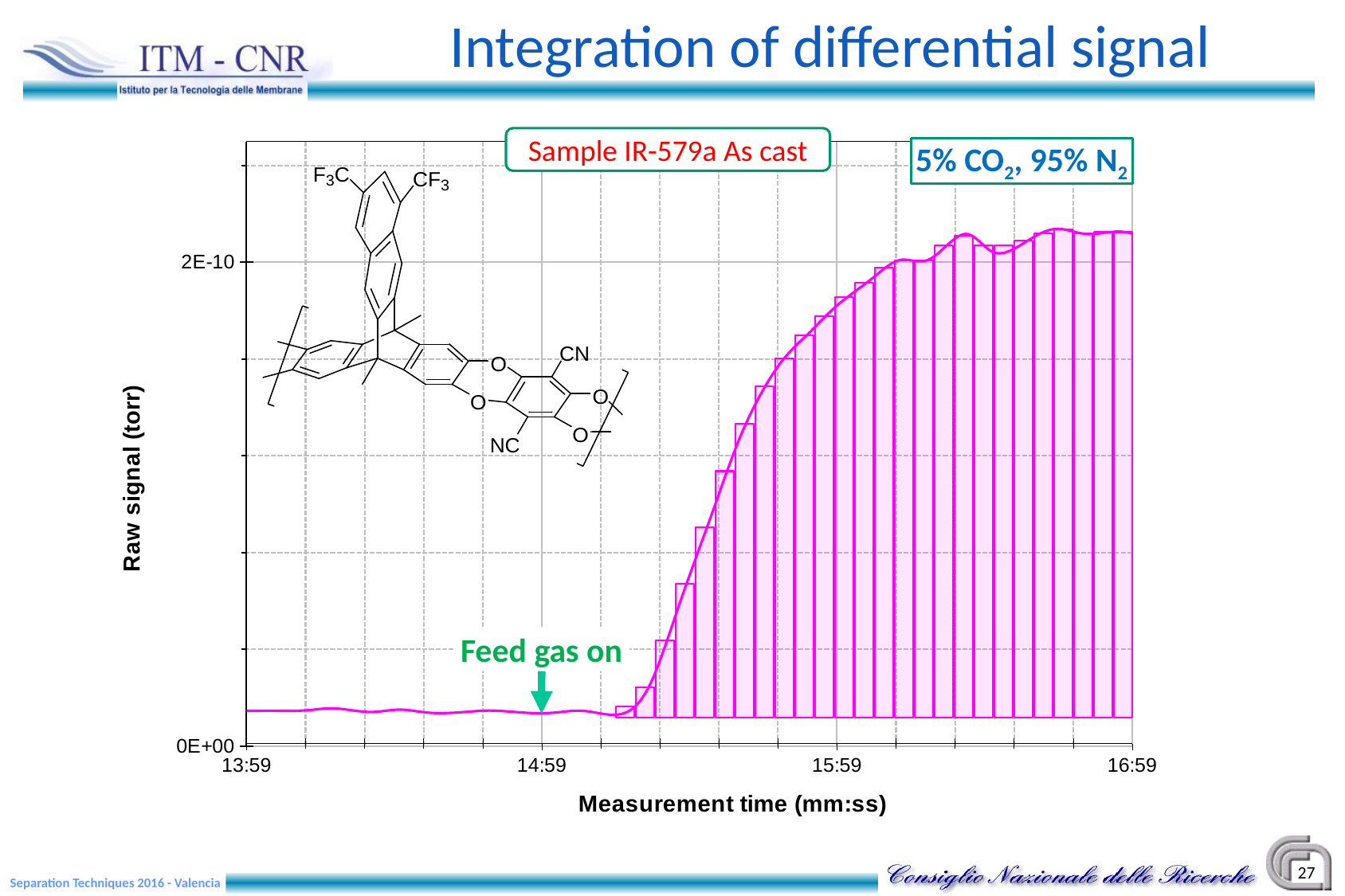
At what measurement time does the 'Feed gas on' arrow point on the x axis? 14:59 Does the raw signal rise or fall between 14:59 and 15:59 on the x axis? rise What kind of chart is shown on the slide? line chart Which is larger, the raw signal at 13:59 or the raw signal at 16:59? 16:59 What is the label of the x axis of the chart? Measurement time (mm:ss) Is the raw signal at 14:59 greater or less than 2E-10? less Is the raw signal at 16:59 greater or less than 2E-10? greater Is the raw signal at 13:59 greater or less than 2E-10? less How many labelled tick marks are shown on the x axis? 4 What is the label of the y axis of the chart? Raw signal (torr) What is the highest labelled value on the y axis? 2E-10 Which is larger, the raw signal at 15:59 or the raw signal at 14:59? 15:59